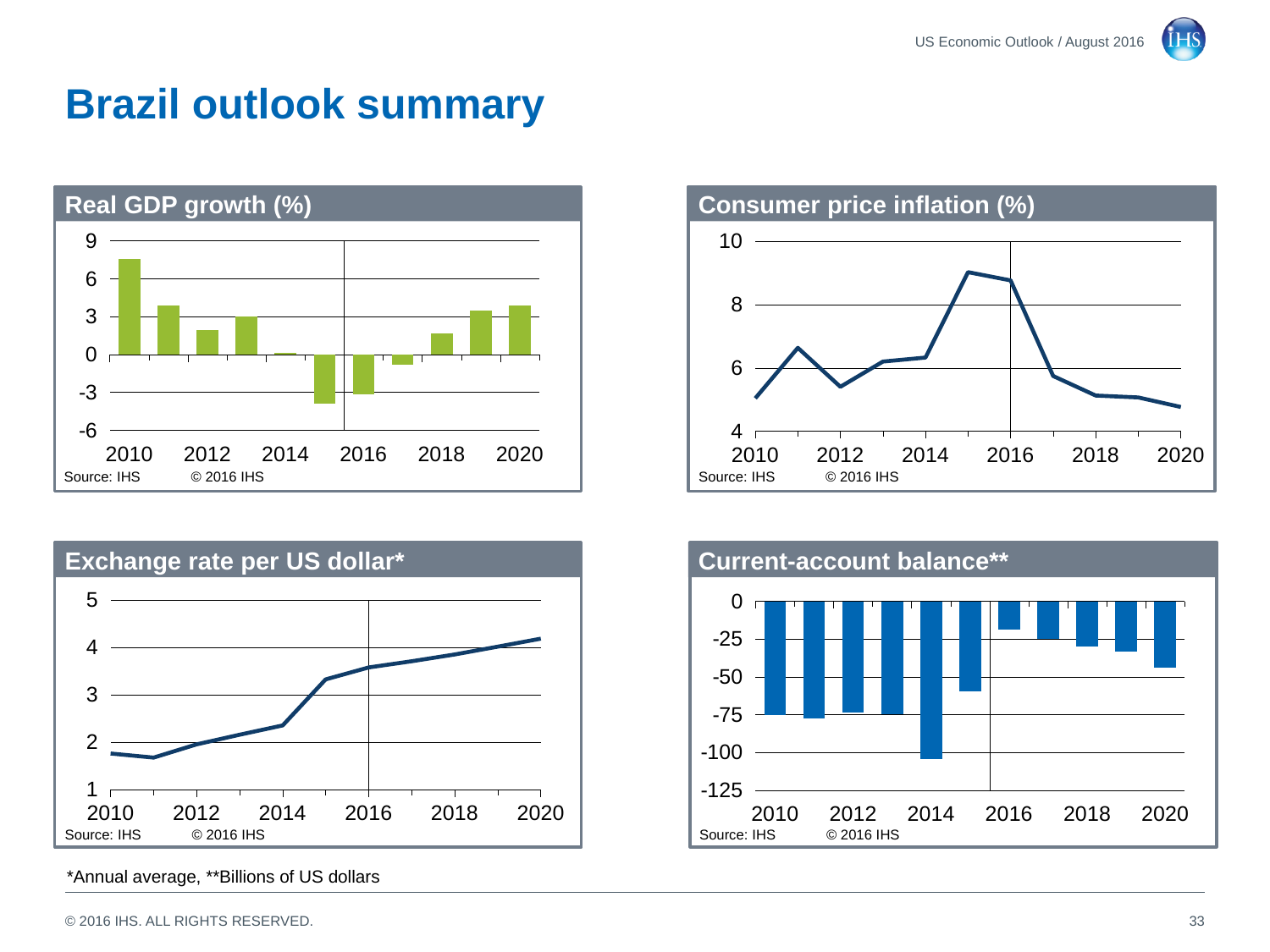
In the 'Exchange rate per US dollar*' chart, do values generally rise or fall from 2010 to 2020? rise How many bars are in the 'Current-account balance**' chart? 11 In the 'Current-account balance**' chart, which year has the lowest value? 2014 In the 'Current-account balance**' chart, is the value for 2014 greater or less than -100? less In the 'Consumer price inflation (%)' chart, is the value for 2020 greater or less than 6? less What kind of chart is the 'Real GDP growth (%)' chart? bar chart In the 'Real GDP growth (%)' chart, which year has the highest value? 2010 In the 'Consumer price inflation (%)' chart, which year has the highest value? 2015 In the 'Exchange rate per US dollar*' chart, is the value for 2020 greater or less than 4? greater In the 'Real GDP growth (%)' chart, which year has the lowest value? 2015 What kind of chart is the 'Consumer price inflation (%)' chart? line chart